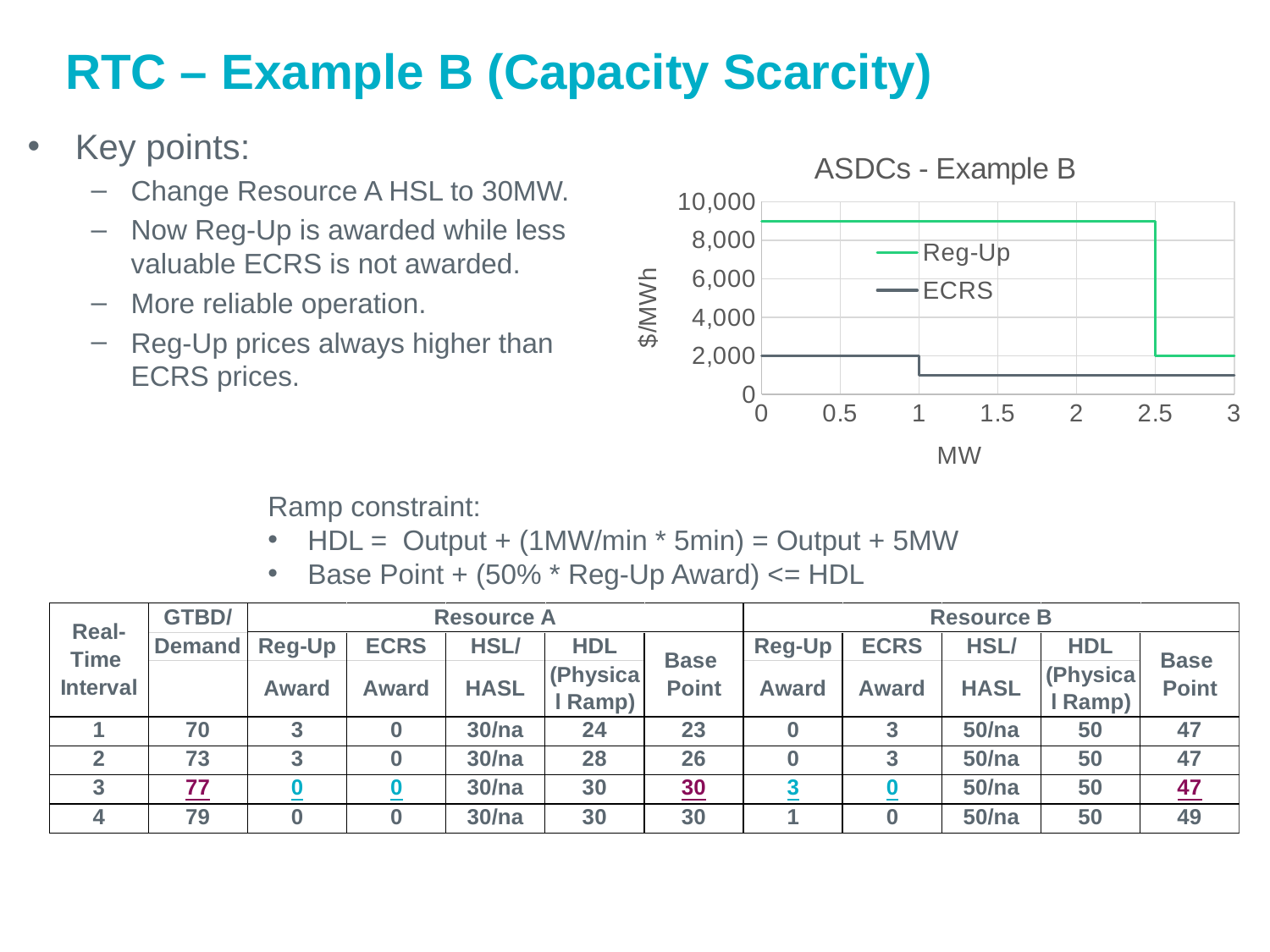
In the 'ASDCs - Example B' chart, at what MW value does the ECRS line step down? 1 In the 'ASDCs - Example B' chart, is the ECRS value at 2 MW greater or less than 2,000? less In the 'ASDCs - Example B' chart, does the Reg-Up line rise or fall as MW increases from 0 to 3? fall In the 'ASDCs - Example B' chart, is the Reg-Up value at 3 MW greater or less than 4,000? less What is the label on the y axis of the 'ASDCs - Example B' chart? $/MWh In the 'ASDCs - Example B' chart, which series has the higher value at 2 MW, Reg-Up or ECRS? Reg-Up In the 'ASDCs - Example B' chart, is the Reg-Up value at 1 MW greater or less than 8,000? greater What kind of chart is 'ASDCs - Example B'? line chart In the 'ASDCs - Example B' chart, at what MW value does the Reg-Up line step down? 2.5 What are the two series named in the legend of the 'ASDCs - Example B' chart? Reg-Up and ECRS How many series does the legend of the 'ASDCs - Example B' chart list? 2